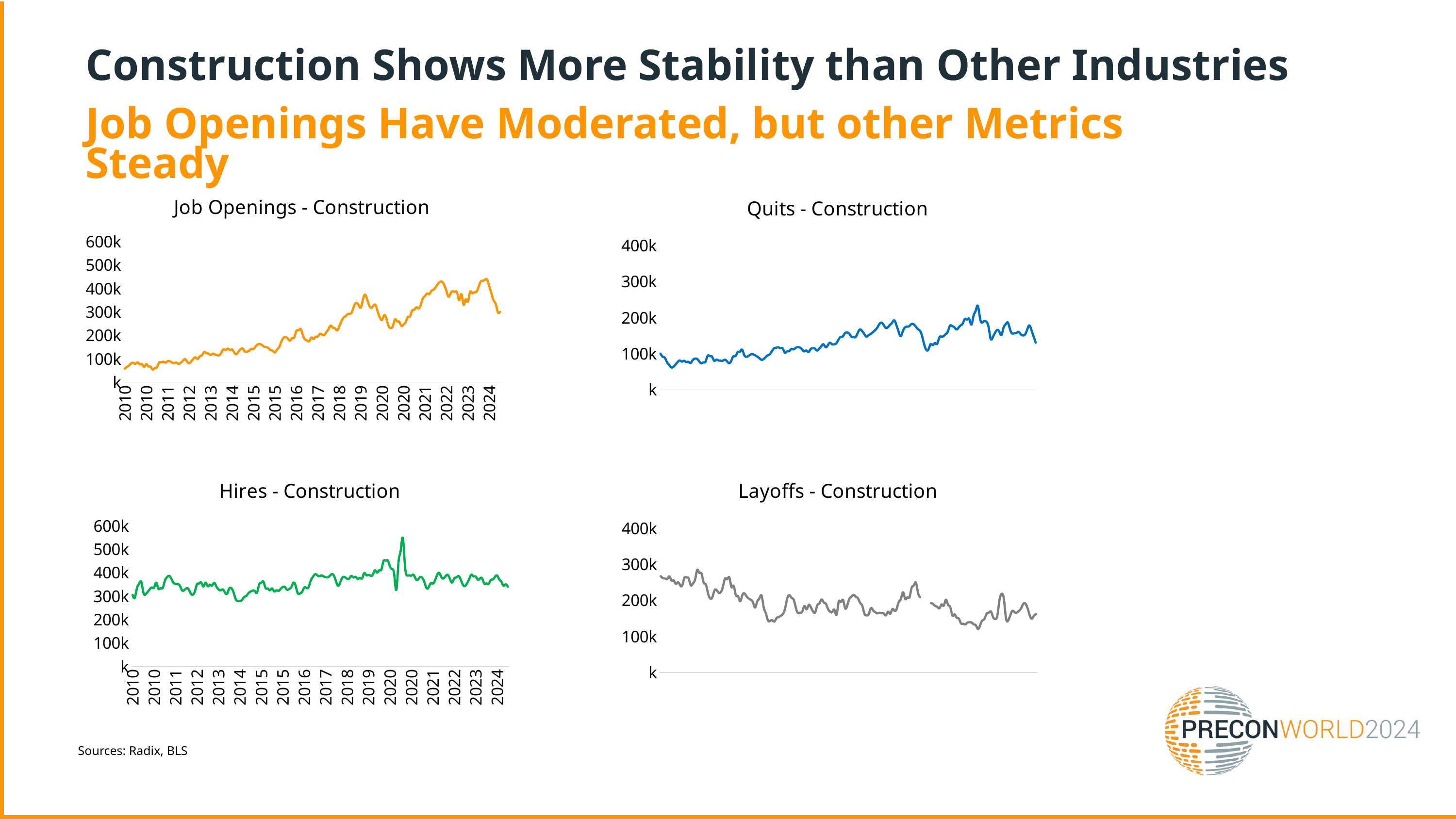
Which chart on the slide uses an orange line? Job Openings - Construction In the "Layoffs - Construction" chart, is the value at the start of the series greater or less than 200k? greater In the "Layoffs - Construction" chart, do layoffs generally rise or fall from 2010 to 2024? fall In the "Job Openings - Construction" chart, is the value at the start of 2010 greater or less than 200k? less In the "Quits - Construction" chart, do quits generally rise or fall between 2010 and 2022? rise In the "Hires - Construction" chart, is the spike in 2020 greater or less than 500k? greater How many charts are shown on the slide? 4 What kind of chart is the "Job Openings - Construction" chart? line chart In the "Job Openings - Construction" chart, do job openings generally rise or fall from 2010 to 2022? rise